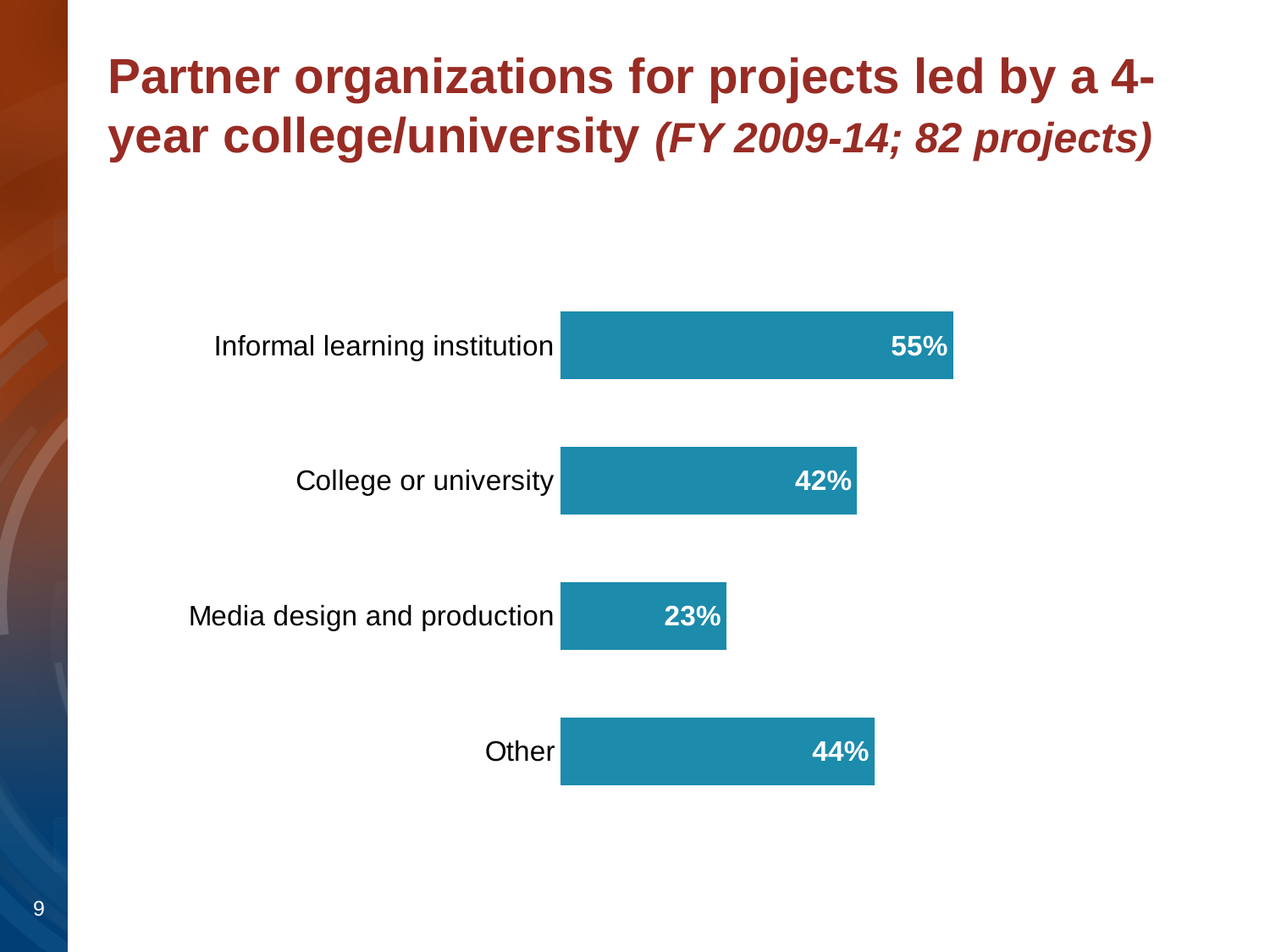
How many projects does the chart title say the data covers? 82 projects What is the value shown for College or university? 42% What percentage is shown for Media design and production? 23% Which partner organization category has the lowest percentage? Media design and production How many partner organization categories are shown in the chart? 4 What percentage of projects had an informal learning institution as a partner organization? 55% Which partner organization category has the highest percentage? Informal learning institution What is the difference in percentage points between Other and College or university? 2 Which is larger, the value for College or university or the value for Media design and production? College or university What is the value for the Other category? 44% What is the difference in percentage points between Informal learning institution and Media design and production? 32 What type of chart is shown on the slide? Bar chart